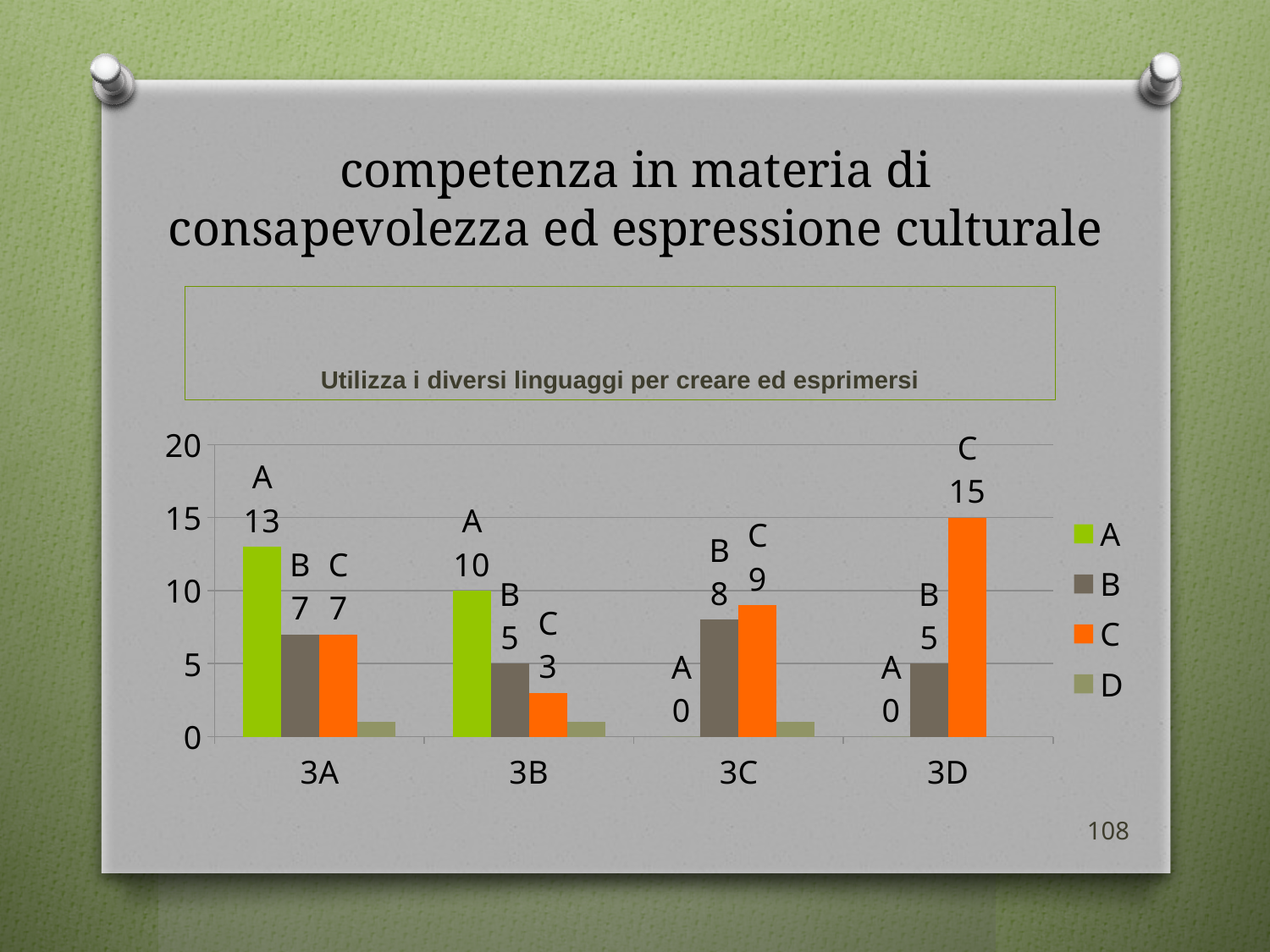
How many series does the legend list? 4 How many categories are shown on the x axis? 4 What is the value of series B for category 3C? 8 What is the value of series C for category 3D? 15 What is the difference between the value of series A for 3A and the value of series A for 3B? 3 Which is larger: series B for 3C or series C for 3C? series C for 3C What is the value of series A for category 3A? 13 Which category has the lowest value for series C? 3B Which category has the highest value for series C? 3D What is the value of series C for category 3B? 3 What kind of chart is shown on the slide? bar chart Is the value of series D for category 3A greater or less than 5? less